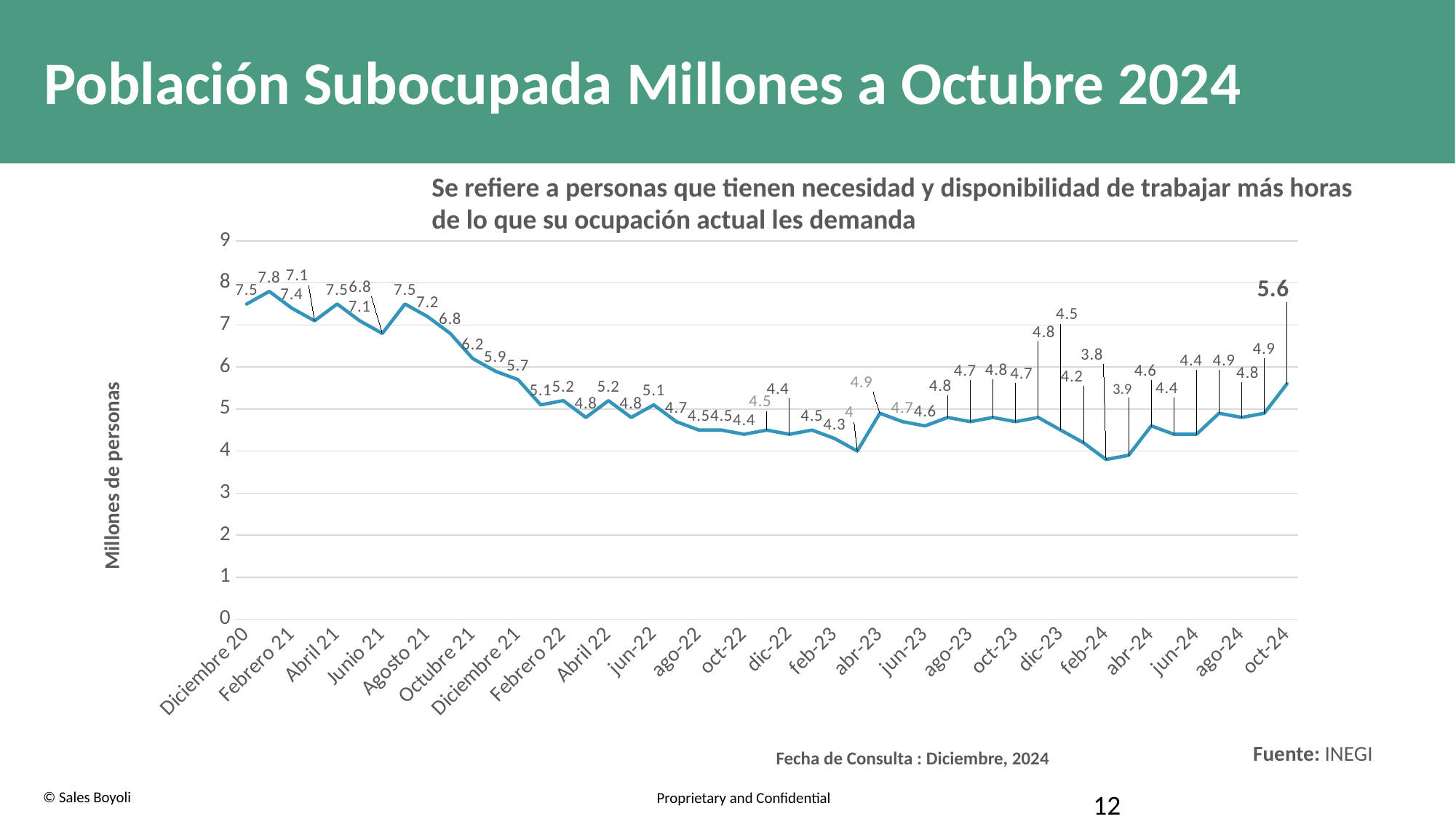
Overall, do the values rise or fall from Diciembre 20 to oct-24? fall What is the title of the vertical axis? Millones de personas What is the value for Diciembre 20? 7.5 How many category labels are shown on the x axis? 24 What is the value for oct-24? 5.6 What type of chart is shown on the slide? line chart Which is larger, the value for Diciembre 20 or the value for oct-24? Diciembre 20 What is the value for feb-24? 3.8 What is the difference between the value for Diciembre 20 and the value for oct-24? 1.9 What is the highest value plotted on the chart? 7.8 Is the value for jun-24 greater or less than 5? less What is the lowest value plotted on the chart? 3.8